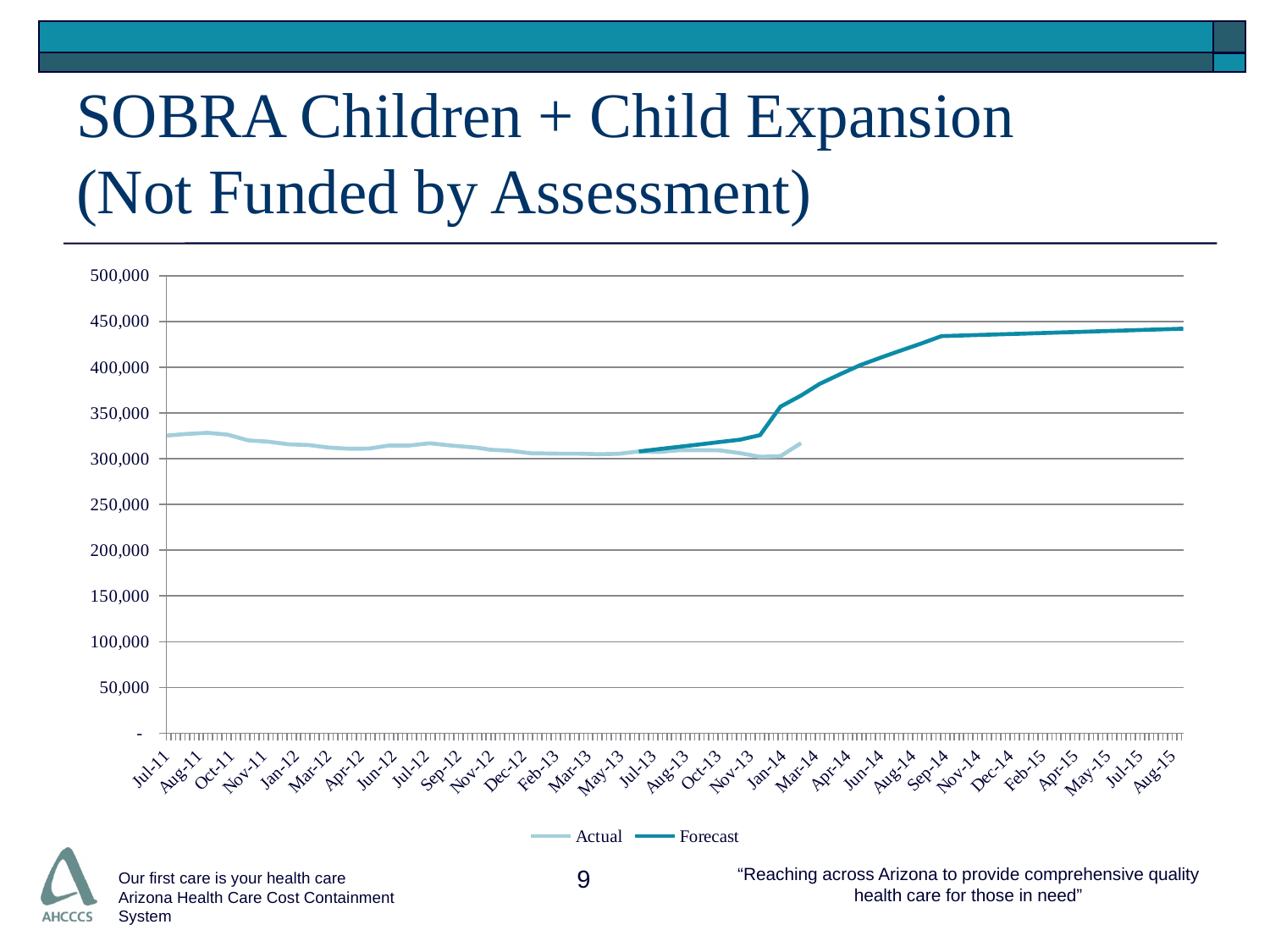
Is the Actual value for Jul-11 greater or less than 300,000? greater What kind of chart is shown on the slide? line chart How many series does the legend list? 2 Does the Forecast series rise or fall between Jul-13 and Aug-15? rise Is the Forecast value for Aug-15 greater or less than 400,000? greater What is the highest value shown on the vertical axis? 500,000 Is the Actual value for Jul-11 greater or less than 350,000? less What are the two series named in the legend? Actual and Forecast Which is larger: the Forecast value at Aug-15 or the Actual value at Jul-11? Forecast at Aug-15 Which series reaches the highest value on the chart? Forecast